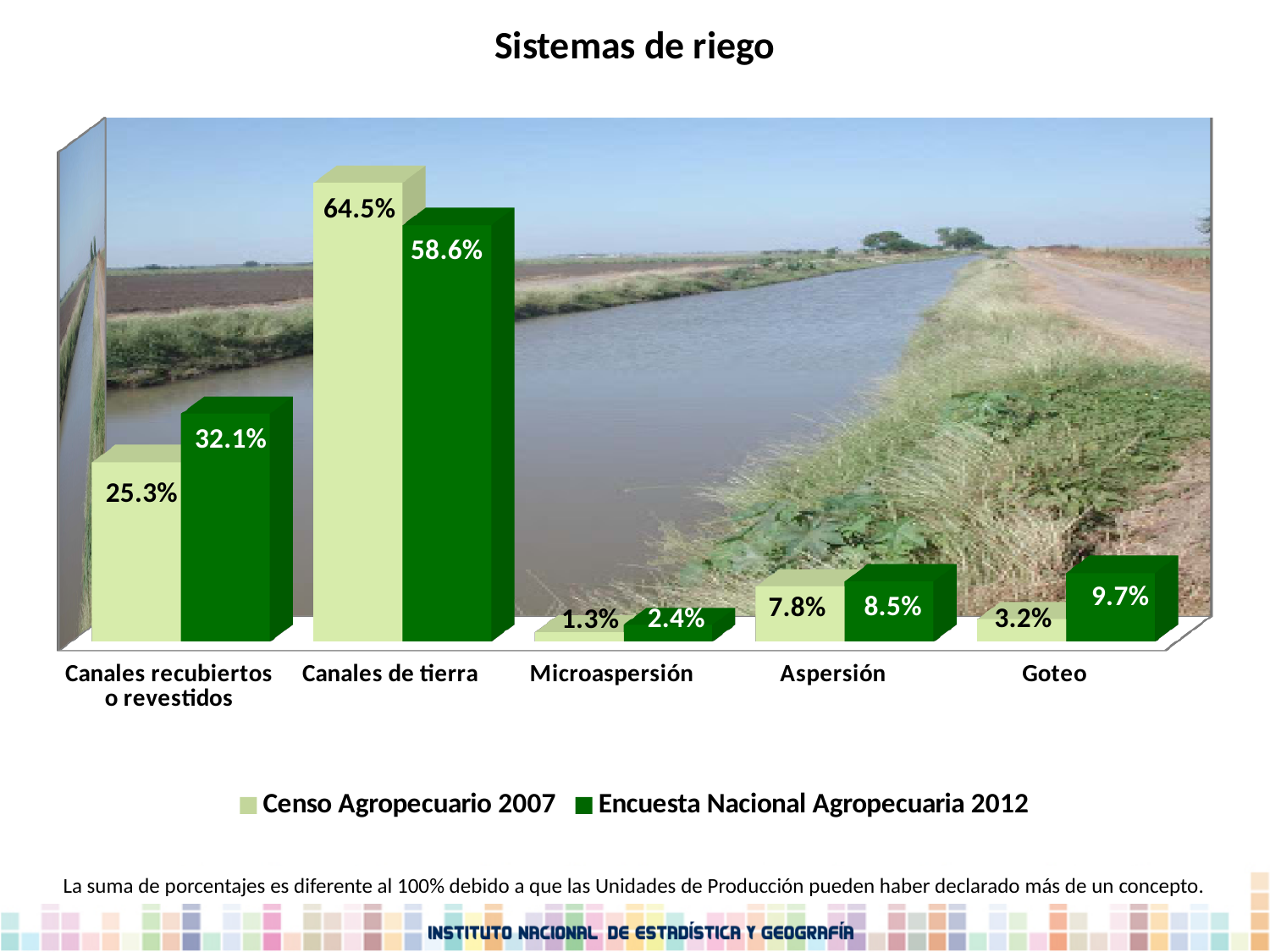
Which category has the highest value in the Encuesta Nacional Agropecuaria 2012 series? Canales de tierra What is the value for Canales de tierra in the Censo Agropecuario 2007 series? 64.5% How many series does the legend list? 2 Which category has the lowest value in the Censo Agropecuario 2007 series? Microaspersión What is the difference between the Censo Agropecuario 2007 and Encuesta Nacional Agropecuaria 2012 values for Canales de tierra? 5.9% What kind of chart is shown on the slide? Bar chart What is the difference between the Encuesta Nacional Agropecuaria 2012 and Censo Agropecuario 2007 values for Goteo? 6.5% What is the value for Goteo in the Encuesta Nacional Agropecuaria 2012 series? 9.7% Which is larger for Aspersión: the Censo Agropecuario 2007 value or the Encuesta Nacional Agropecuaria 2012 value? Encuesta Nacional Agropecuaria 2012 What is the value for Canales recubiertos o revestidos in the Censo Agropecuario 2007 series? 25.3% What is the value for Microaspersión in the Encuesta Nacional Agropecuaria 2012 series? 2.4% How many categories are shown on the x axis? 5